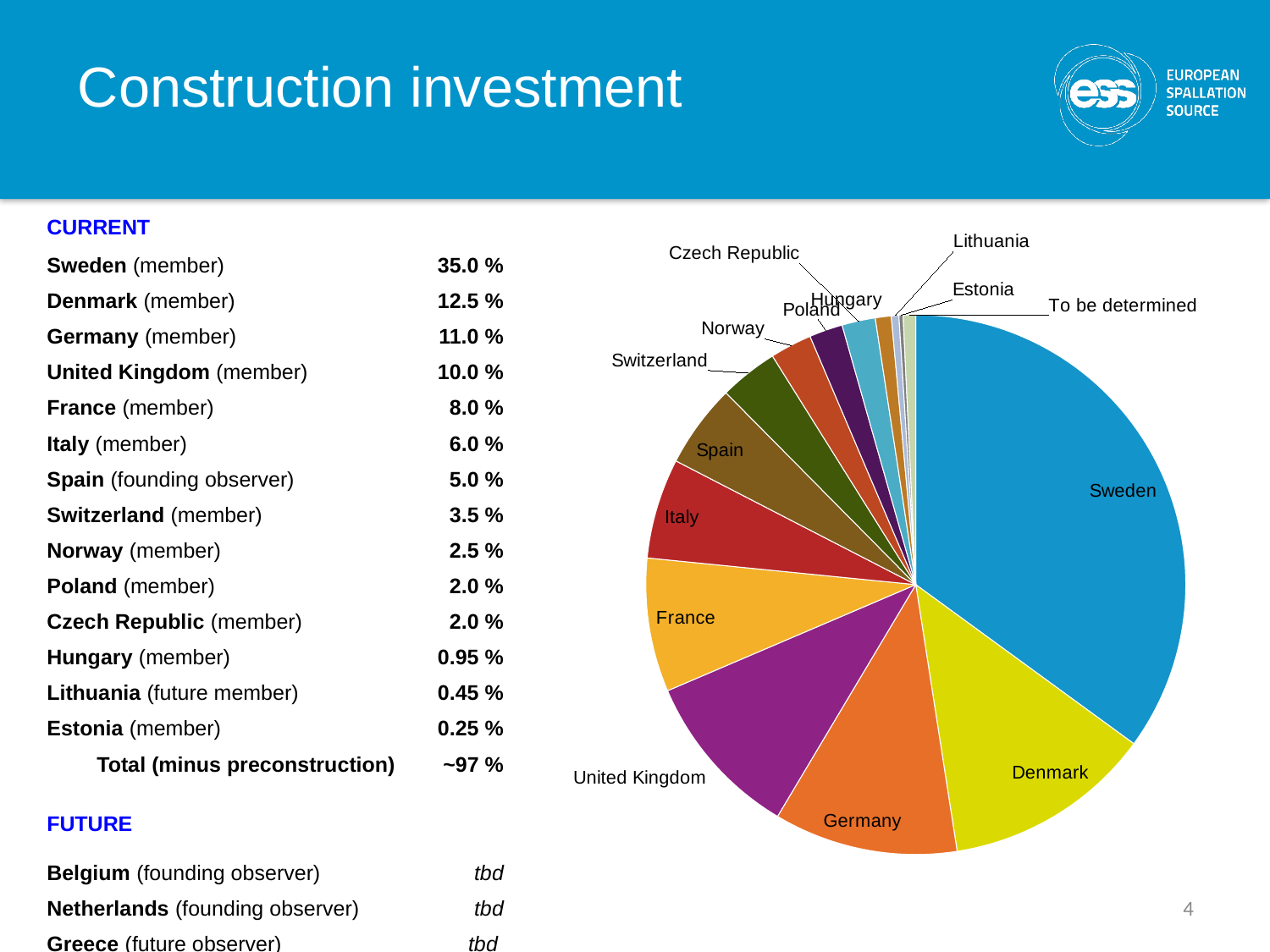
What colour is the Sweden slice in the pie chart? blue What is Sweden's share of the construction investment? 35.0 % What kind of chart is shown on the slide? pie chart Which slice is larger, France or Italy? France Which country has the largest slice of the pie chart? Sweden Which slice is larger, Sweden or Denmark? Sweden What is Denmark's share of the construction investment? 12.5 % What is the title of the slide containing the pie chart? Construction investment What is the difference between Sweden's share and Denmark's share? 22.5 % How many slices does the pie chart have? 15 What is the value shown for Hungary? 0.95 % What is the value shown for Switzerland? 3.5 %